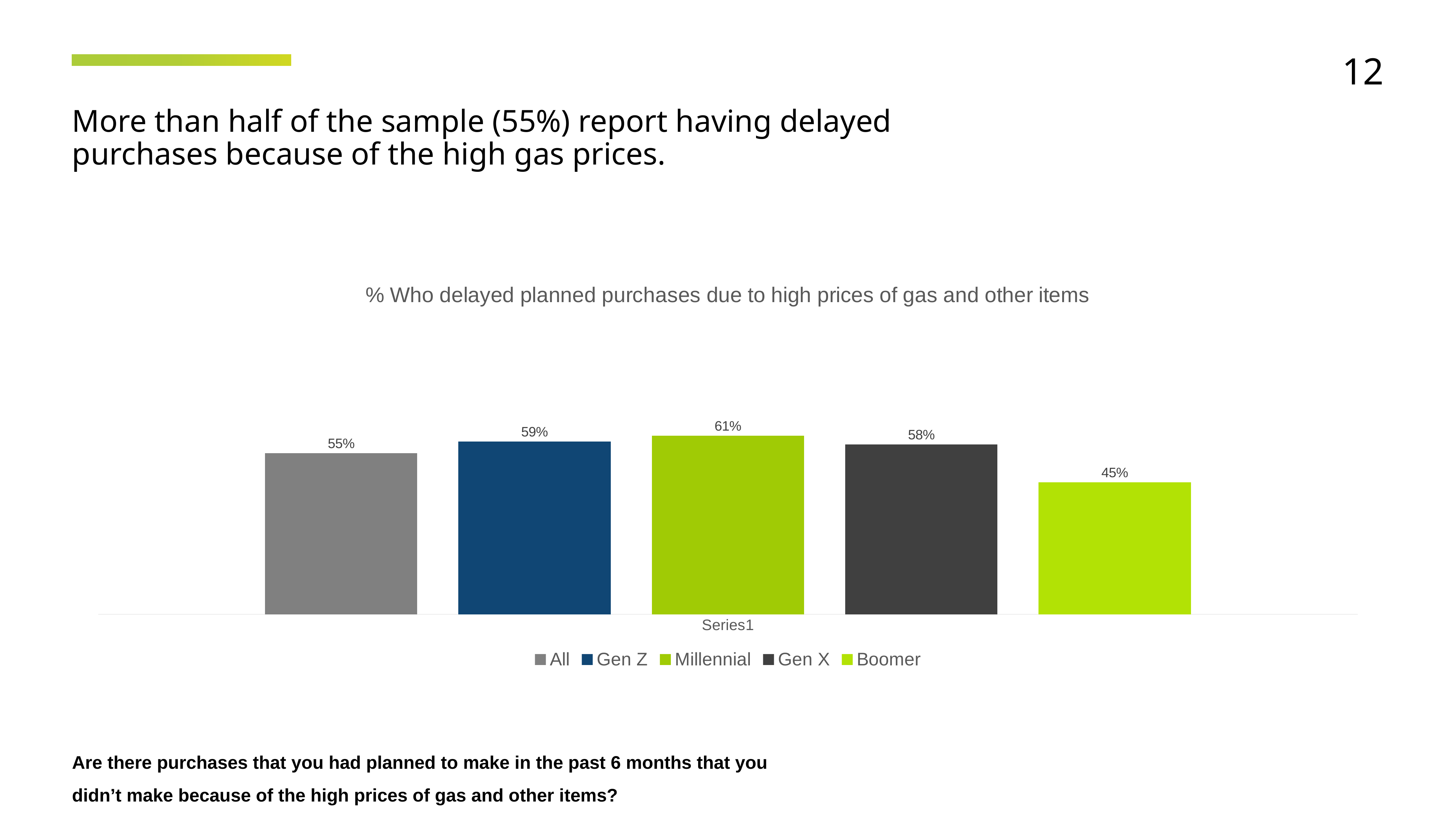
What is the value for Gen Z? 59% Which is larger, the value for Gen X or the value for Boomer? Gen X Which group has the highest value? Millennial What kind of chart is shown? Bar chart How many series does the legend list? 5 What is the value for Millennial? 61% What is the difference between the Millennial and Boomer values? 16% What is the title of the chart? % Who delayed planned purchases due to high prices of gas and other items Which group has the lowest value? Boomer What is the value for Boomer? 45% What is the difference between the Gen Z and All values? 4% What is the value for All? 55%